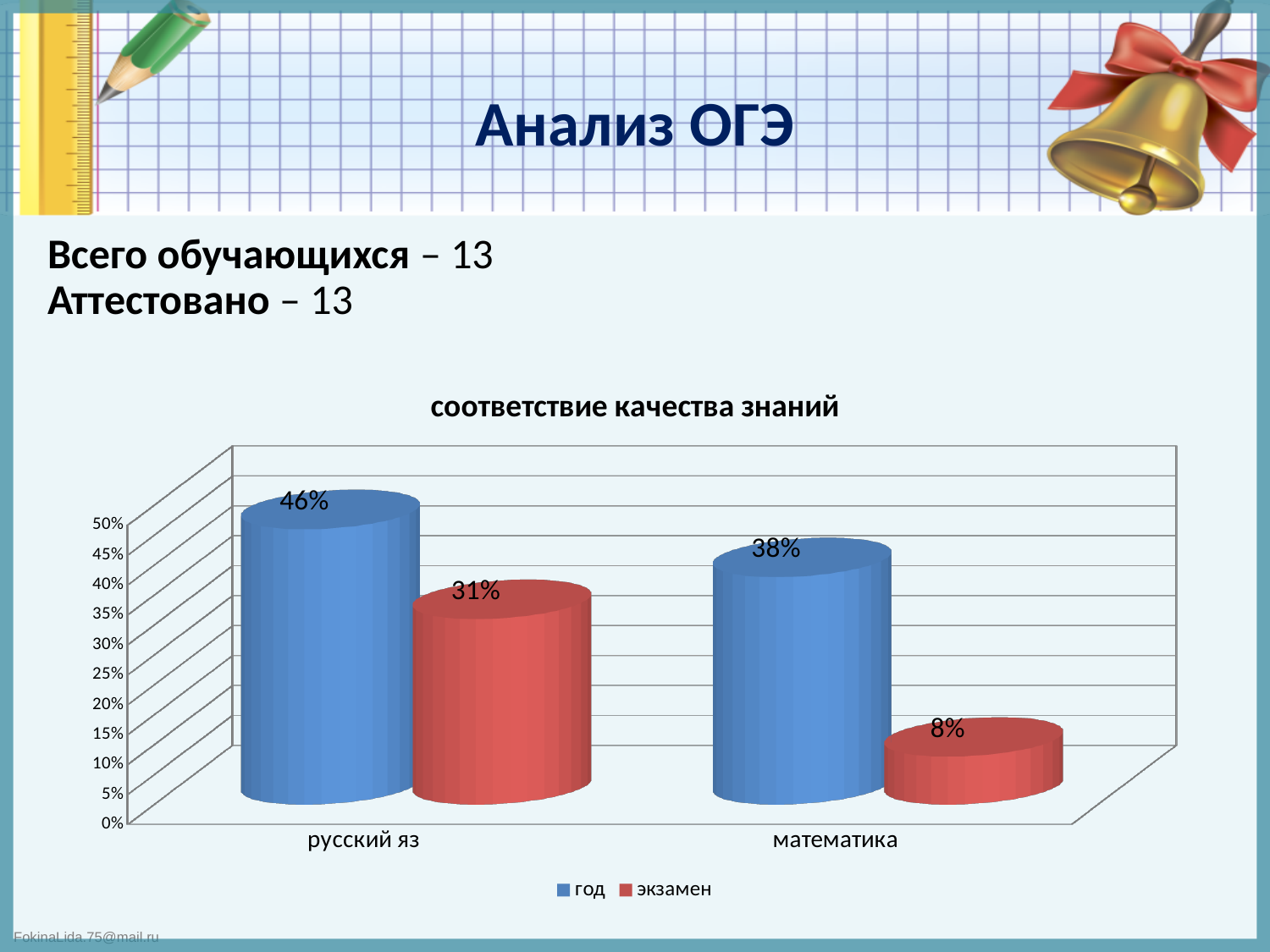
What is the difference between the "год" and "экзамен" values for "математика"? 30% What is the title of the chart? соответствие качества знаний How many categories are shown on the x axis? 2 What is the difference between the "год" and "экзамен" values for "русский яз"? 15% What is the value for "экзамен" for "русский яз"? 31% Which category has the highest "год" value? русский яз What is the value for "год" for "русский яз"? 46% Which is larger for "русский яз": the "год" value or the "экзамен" value? год What is the value for "год" for "математика"? 38% Which category has the lowest "экзамен" value? математика What is the value for "экзамен" for "математика"? 8% How many series does the legend list? 2